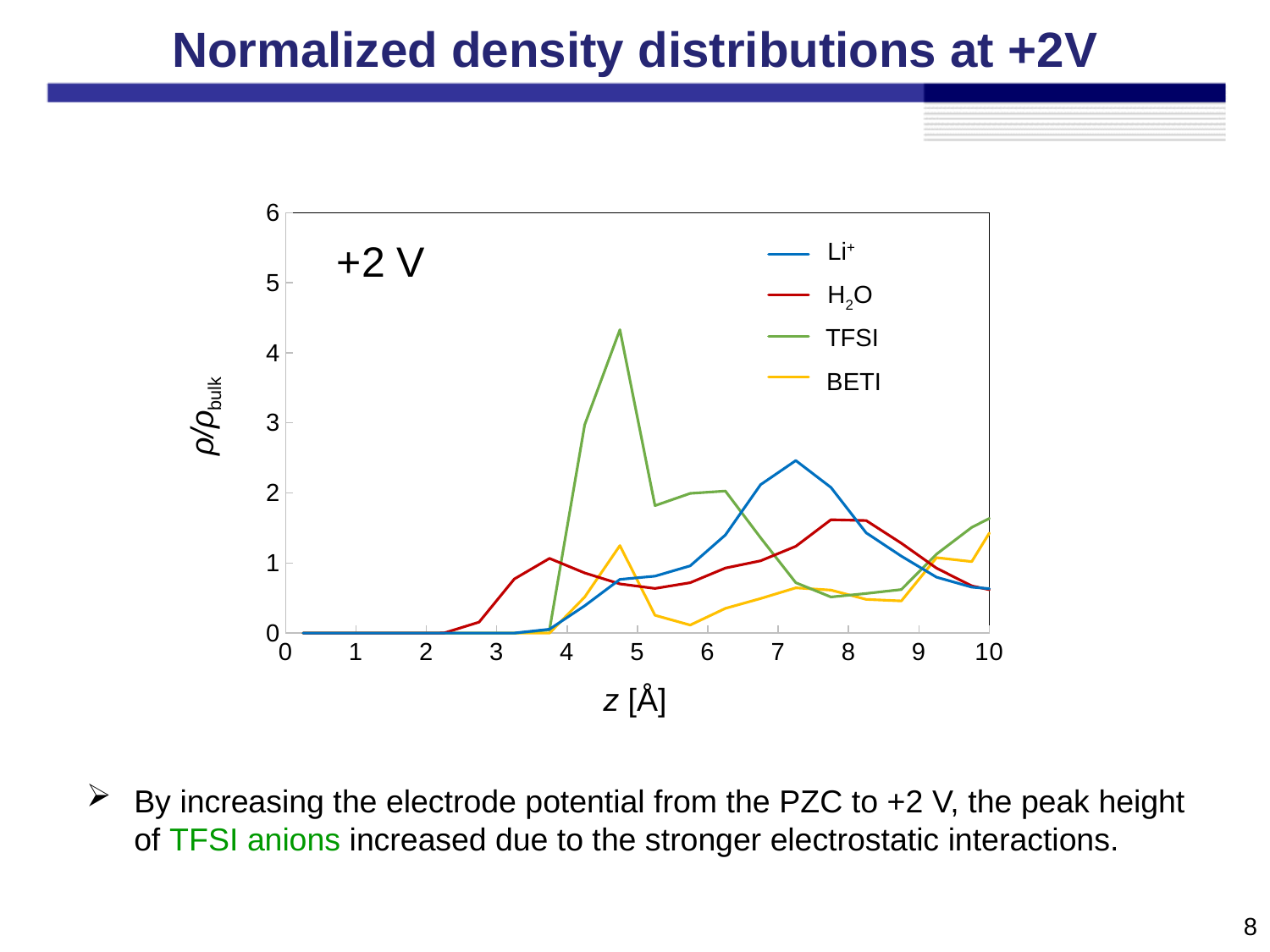
Which has a higher peak, the Li+ curve or the H2O curve? Li+ Which series reaches the highest peak value of ρ/ρbulk? TFSI What colour is the TFSI line in the legend? green Between z = 8 Å and z = 10 Å, does the Li+ curve rise or fall? fall Is the peak value of the Li+ curve greater or less than 2? greater What is the label of the x axis? z [Å] Is the peak value of the Li+ curve greater or less than 3? less Is the peak value of the H2O curve greater or less than 2? less Between z = 4 Å and z = 7 Å, does the Li+ curve rise or fall? rise How many series does the legend list? 4 What kind of chart is shown on the slide? line chart